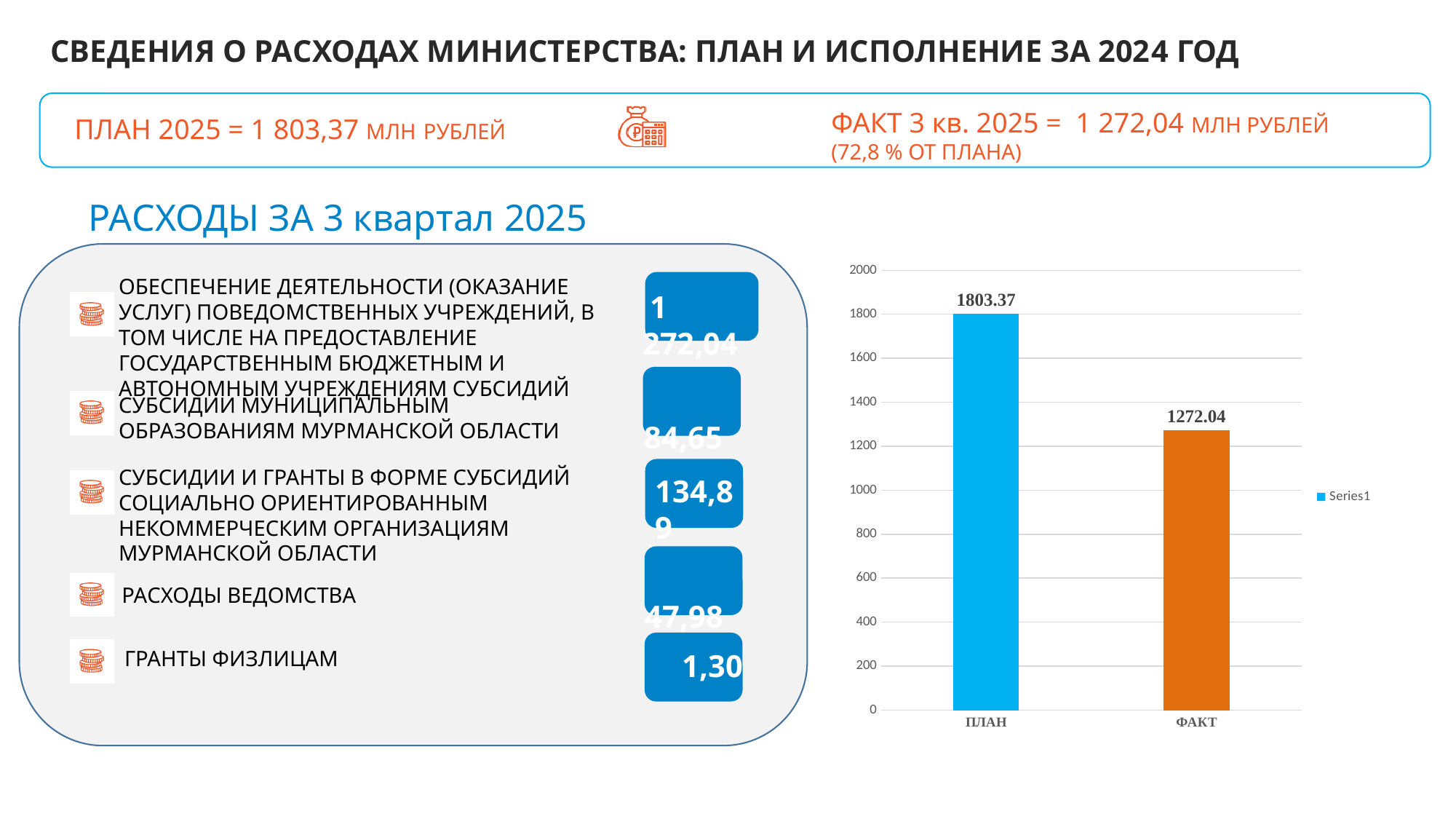
What type of chart is shown on the slide? bar chart What is the difference between the ПЛАН and ФАКТ values in the chart? 531.33 What is the value of the ПЛАН bar in the chart? 1803.37 How many series does the chart legend list? 1 What is the legend entry shown in the chart? Series1 Which is larger in the chart, ПЛАН or ФАКТ? ПЛАН Which category has the lowest bar in the chart? ФАКТ How many bars are shown in the chart? 2 Which category has the highest bar in the chart? ПЛАН Is the value for ПЛАН greater or less than 1600? greater Is the value for ФАКТ greater or less than 1400? less What is the value of the ФАКТ bar in the chart? 1272.04